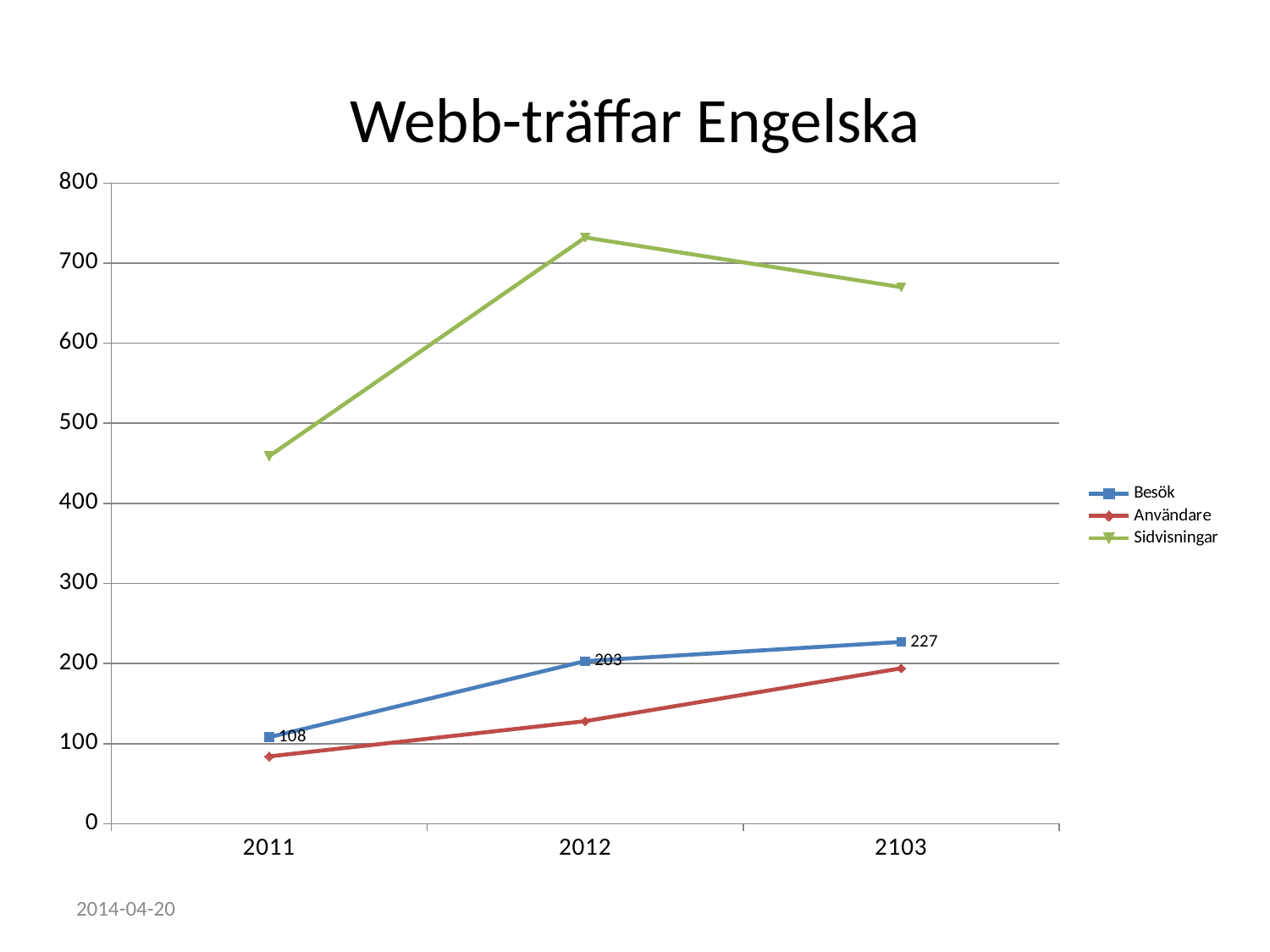
What is the value of Besök in 2012? 203 Which series has the highest values across all years? Sidvisningar Is the value for Användare in 2011 greater or less than 100? less How many points are plotted along the x axis for each series? 3 How many series does the legend list? 3 What is the value of Besök at the last x-axis category (labelled 2103)? 227 What is the difference between the Besök values for 2012 and 2011? 95 What is the value of Besök in 2011? 108 What is the title of the chart? Webb-träffar Engelska What kind of chart is shown on the slide? line chart Do the Besök values rise or fall along the x axis? rise Is the value for Sidvisningar in 2012 greater or less than 700? greater